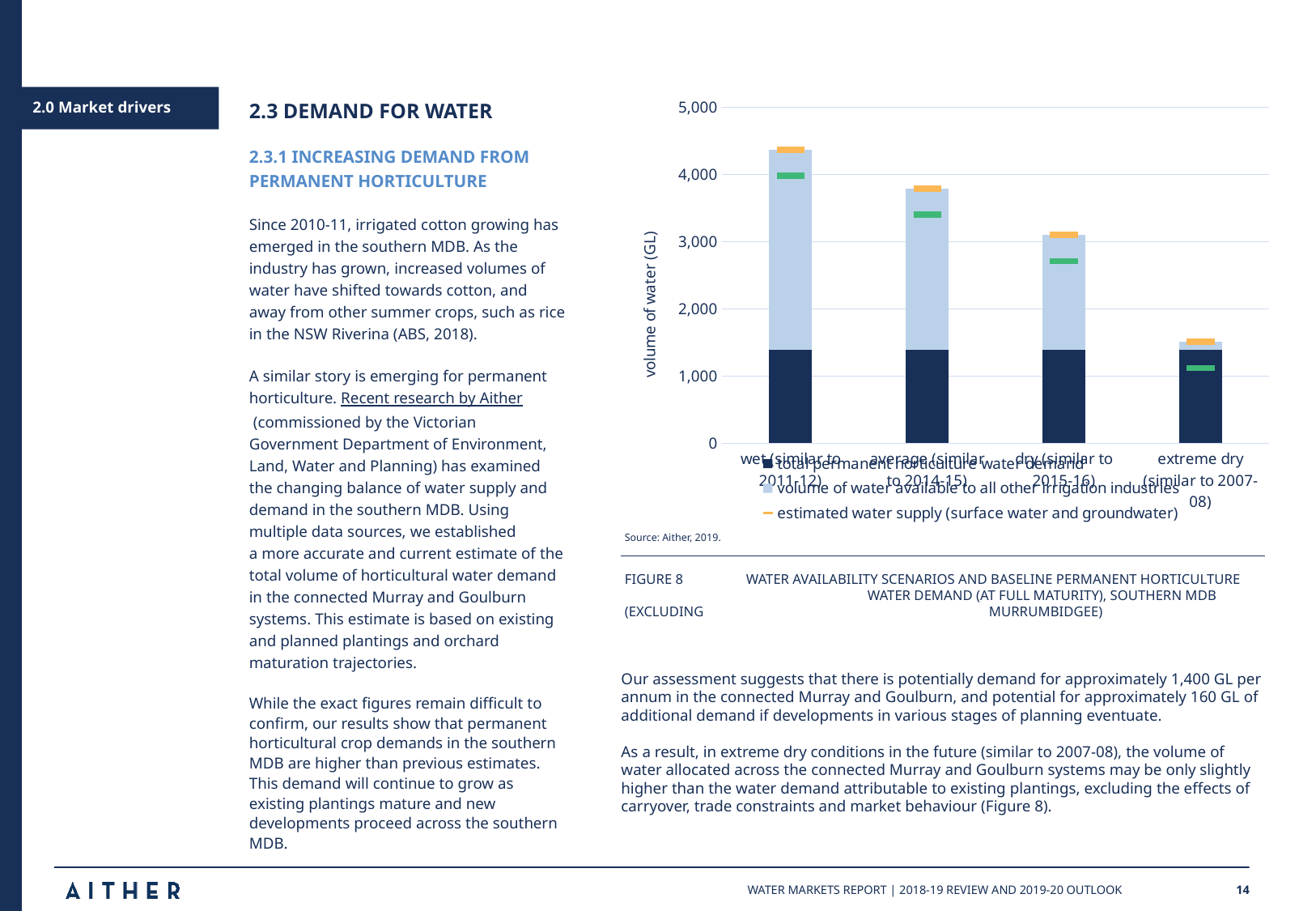
Is the total stacked bar height for the average (similar to 2014-15) scenario greater or less than 4,000? less Is the total permanent horticulture water demand bar for the wet (similar to 2011-12) scenario greater or less than 1,000? greater Which scenario has the tallest stacked bar? wet (similar to 2011-12) Which scenario has the shortest stacked bar? extreme dry (similar to 2007-08) Is the total stacked bar height for the extreme dry (similar to 2007-08) scenario greater or less than 2,000? less What is the label on the y axis of the chart? volume of water (GL) How many series does the legend list? 3 Do the total stacked bar heights rise or fall from left to right across the scenarios? fall What kind of chart is shown on the slide? Stacked bar chart Which has the larger total stacked bar: the wet (similar to 2011-12) scenario or the dry (similar to 2015-16) scenario? wet (similar to 2011-12) How many water availability scenarios (categories) are shown on the x axis? 4